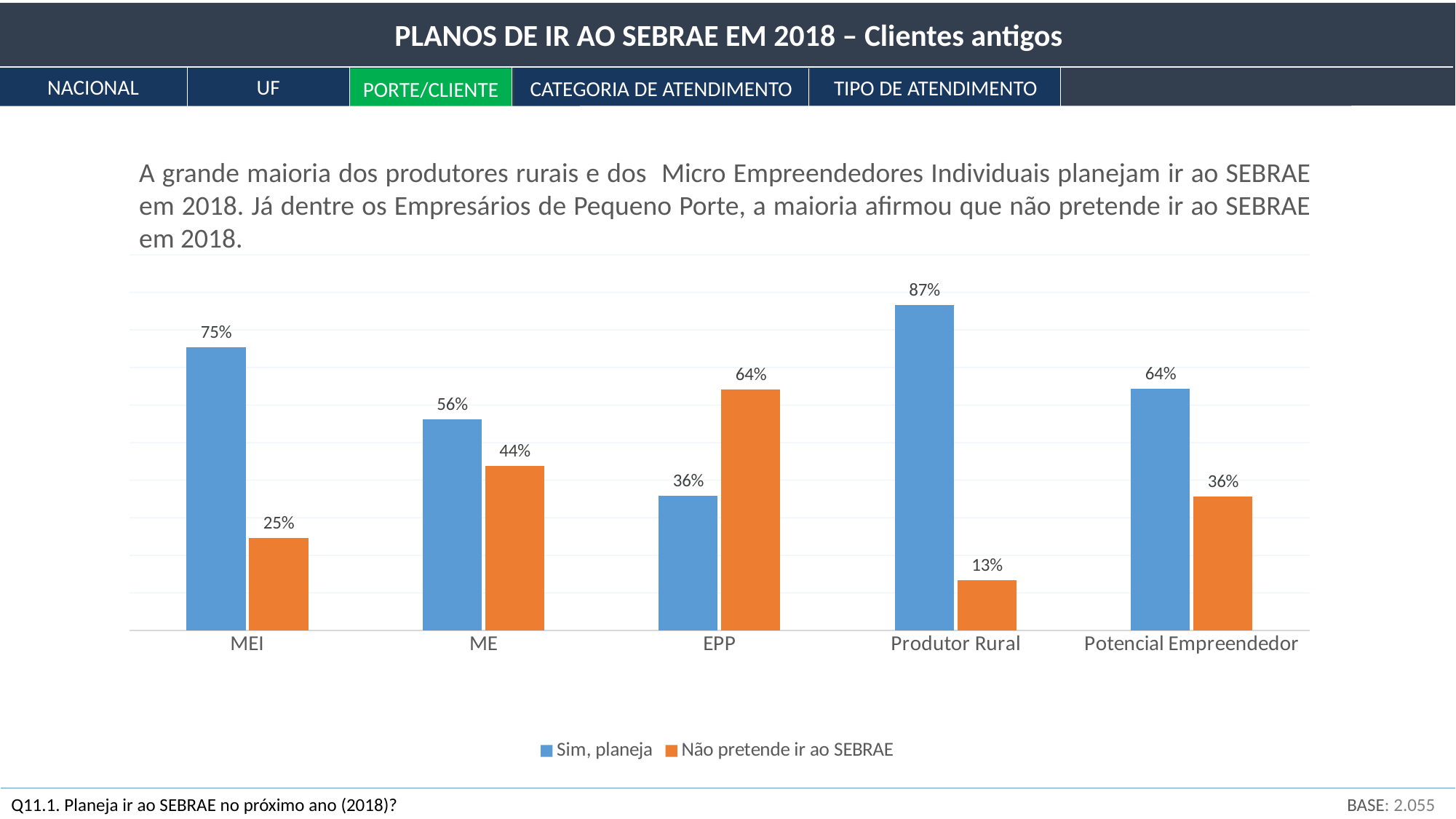
Which category has the lowest value for 'Não pretende ir ao SEBRAE'? Produtor Rural Which colour represents the 'Sim, planeja' series? Blue What kind of chart is shown on the slide? Bar chart How many categories are shown on the x axis? 5 What is the value for 'Não pretende ir ao SEBRAE' for Potencial Empreendedor? 36% What is the value for 'Não pretende ir ao SEBRAE' for EPP? 64% What is the value for 'Sim, planeja' for MEI? 75% For EPP, which is larger: 'Sim, planeja' or 'Não pretende ir ao SEBRAE'? Não pretende ir ao SEBRAE What is the difference between 'Sim, planeja' and 'Não pretende ir ao SEBRAE' for ME? 12% How many series does the legend list? 2 Which category has the highest value for 'Sim, planeja'? Produtor Rural What is the value for 'Sim, planeja' for Produtor Rural? 87%